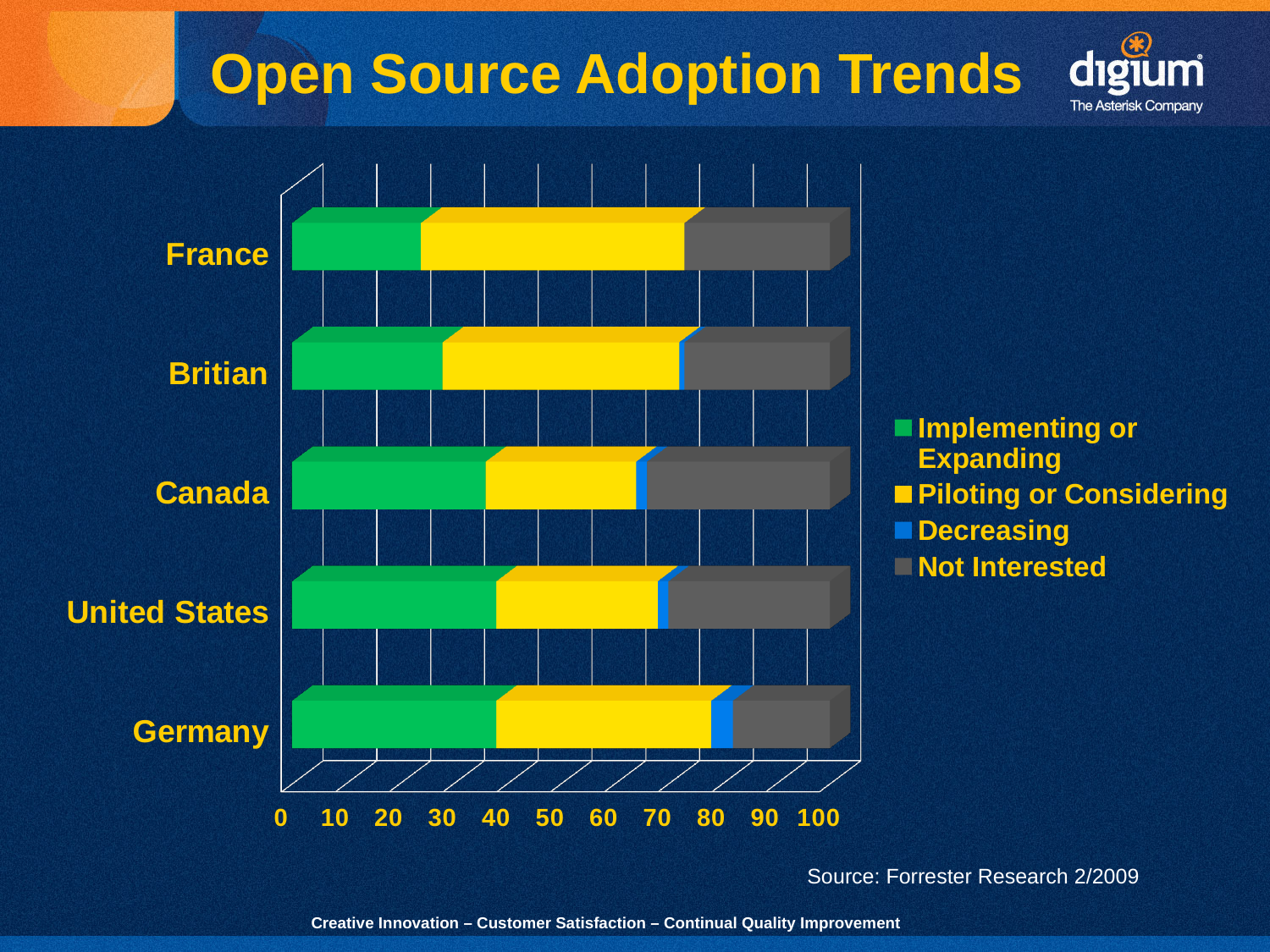
What colour represents the Decreasing series in the legend? blue How many countries are shown on the chart? 5 Which country has the smallest Not Interested segment? Germany Is the Implementing or Expanding value for Canada greater or less than 30? greater What kind of chart is shown on the slide? bar chart What is the title of the chart slide? Open Source Adoption Trends Which has the larger Implementing or Expanding segment, France or Germany? Germany Is the Implementing or Expanding value for Germany greater or less than 30? greater Which has the larger Not Interested segment, France or Germany? France Which has the larger Piloting or Considering segment, France or Canada? France How many series does the legend list? 4 Is the Implementing or Expanding value for France greater or less than 30? less